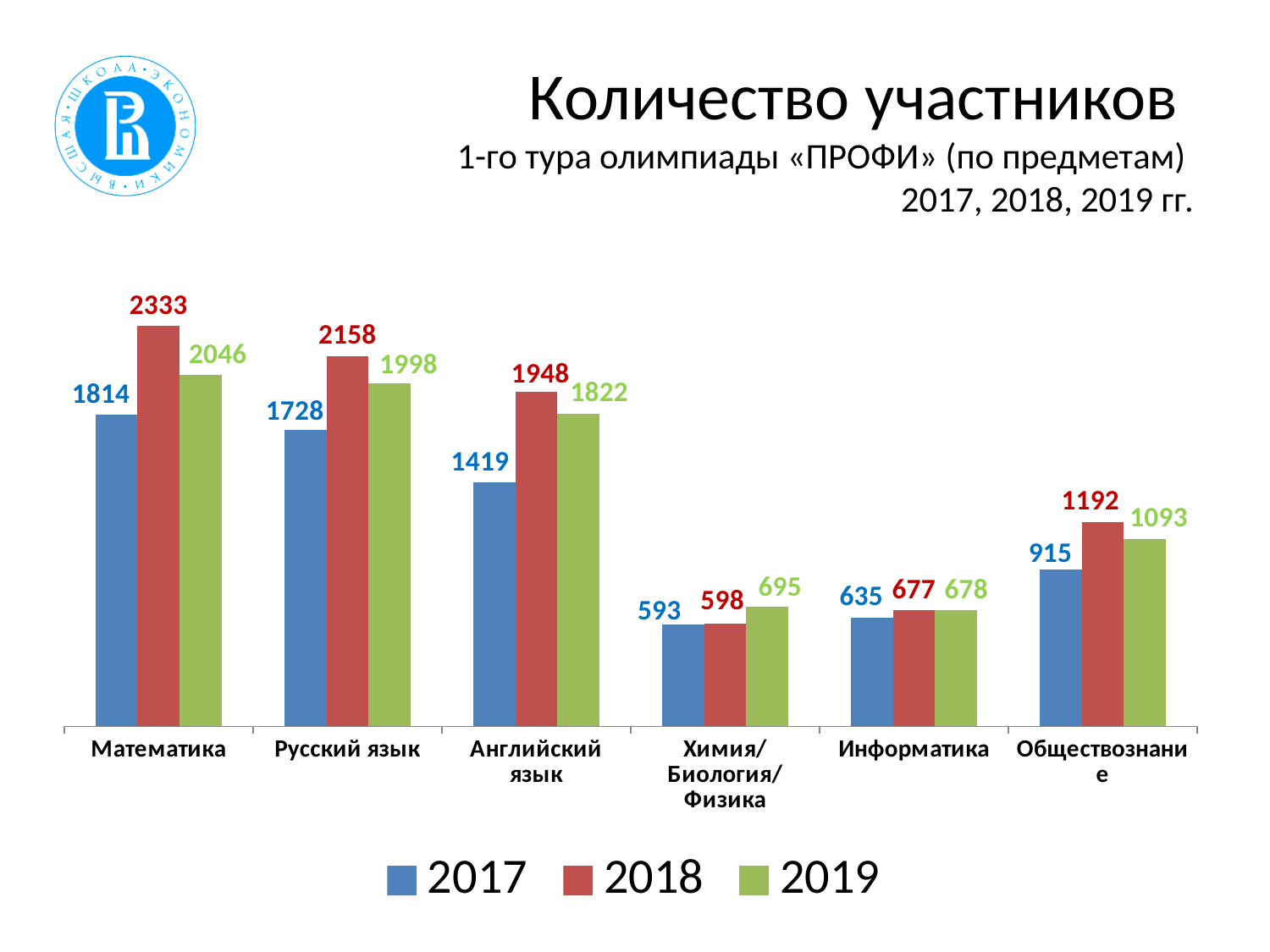
What is the value for Математика in 2018? 2333 Which is larger: the 2019 value for Информатика or the 2019 value for Химия/Биология/Физика? Химия/Биология/Физика How many series does the legend list? 3 What is the value for Английский язык in 2017? 1419 Which colour represents the 2018 series in the legend? red What kind of chart is shown on the slide? bar chart Which category has the lowest value in 2017? Химия/Биология/Физика Do the values for Химия/Биология/Физика rise or fall from 2017 to 2019? rise What is the value for Обществознание in 2019? 1093 What is the difference between the 2018 and 2017 values for Русский язык? 430 How many categories are shown on the x axis? 6 Which category has the highest value in 2019? Математика